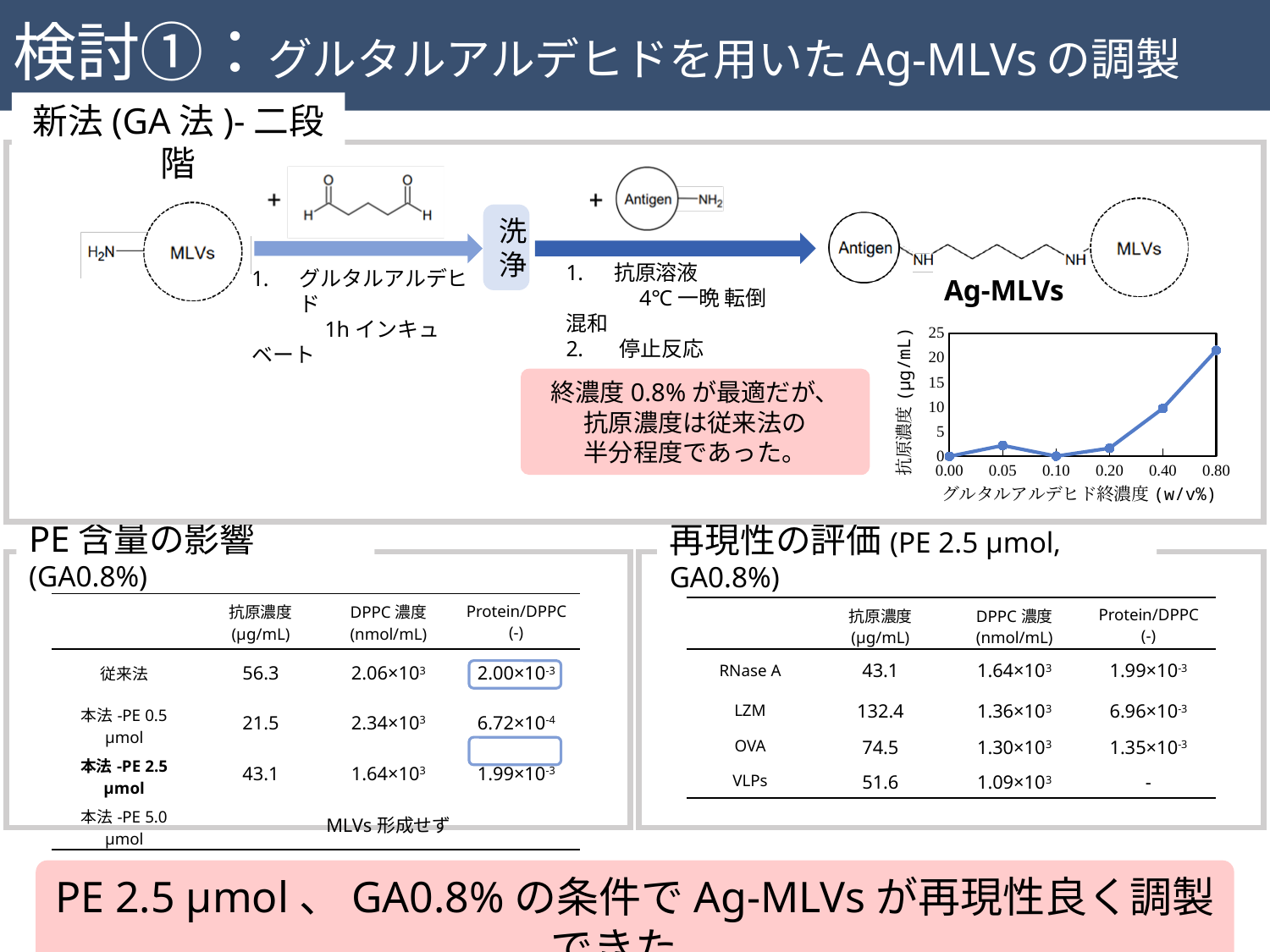
In the line chart, is the antigen concentration at 0.05 w/v% greater or less than 5 μg/mL? less In the line chart, at which glutaraldehyde final concentration (w/v%) is the antigen concentration highest? 0.80 In the line chart, which has the higher antigen concentration: 0.40 w/v% or 0.80 w/v%? 0.80 In the line chart, is the antigen concentration at 0.20 w/v% greater or less than 5 μg/mL? less In the line chart, does the antigen concentration rise or fall from 0.20 w/v% to 0.80 w/v%? rise In the line chart, how many data points are plotted? 6 What is the x-axis title of the line chart? グルタルアルデヒド終濃度 (w/v%) What is the y-axis title of the line chart? 抗原濃度 (μg/mL) In the line chart, is the antigen concentration at 0.40 w/v% greater or less than 15 μg/mL? less What kind of chart is shown in the upper right of the slide (抗原濃度 vs グルタルアルデヒド終濃度)? line chart